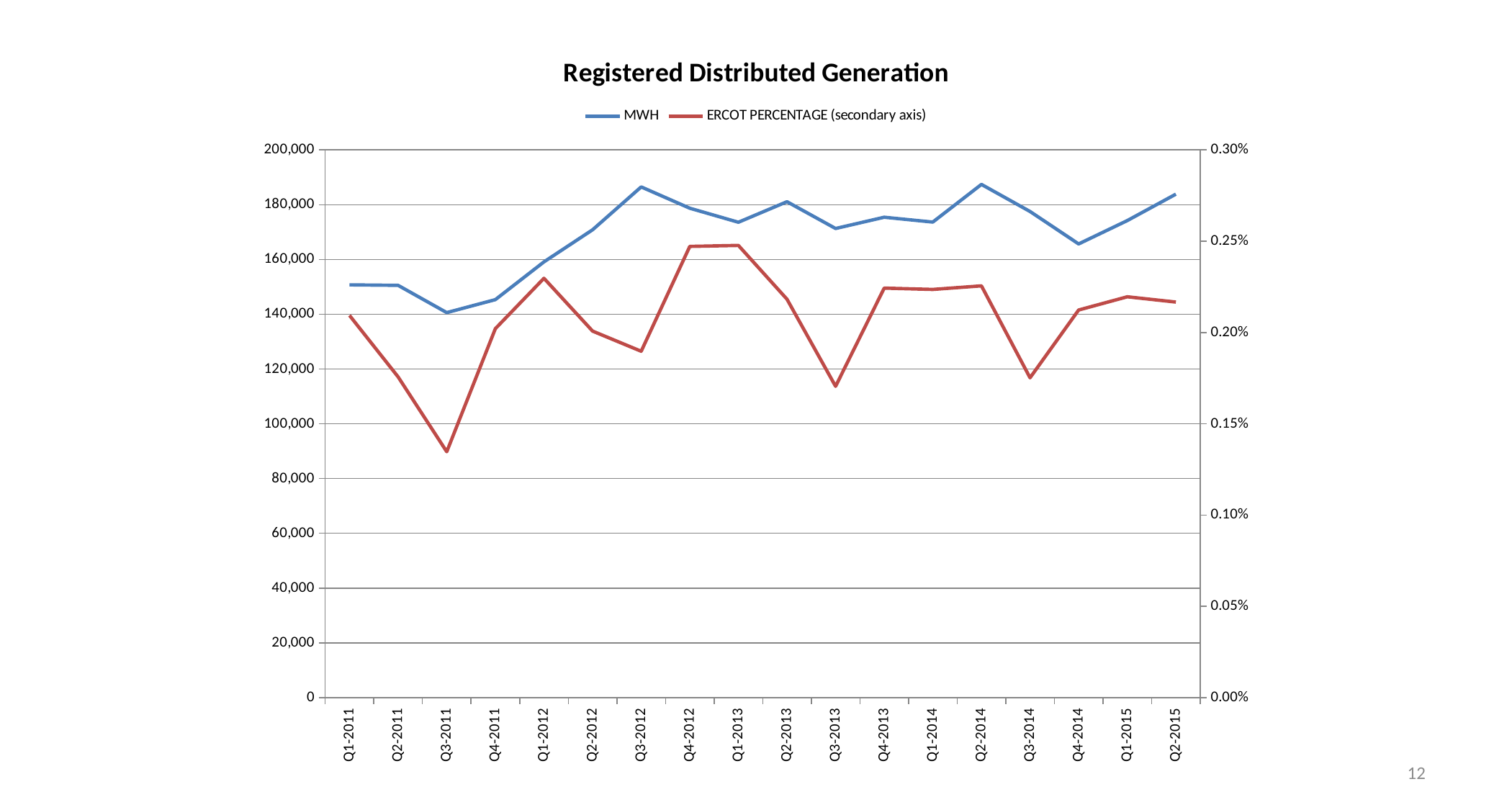
Is the MWH value for Q3-2011 greater or less than 160,000? less Which has the larger MWH value, Q3-2011 or Q3-2012? Q3-2012 Which quarter has the lowest ERCOT PERCENTAGE value? Q3-2011 How many series does the legend list? 2 Is the MWH value for Q3-2012 greater or less than 180,000? greater Does the MWH series rise or fall from Q3-2011 to Q3-2012? rise What kind of chart is shown on the slide? line chart How many quarters are plotted along the x axis? 18 Is the ERCOT PERCENTAGE value for Q3-2011 greater or less than 0.15%? less Which quarter has the lowest MWH value? Q3-2011 Which series is plotted on the secondary axis according to the legend? ERCOT PERCENTAGE